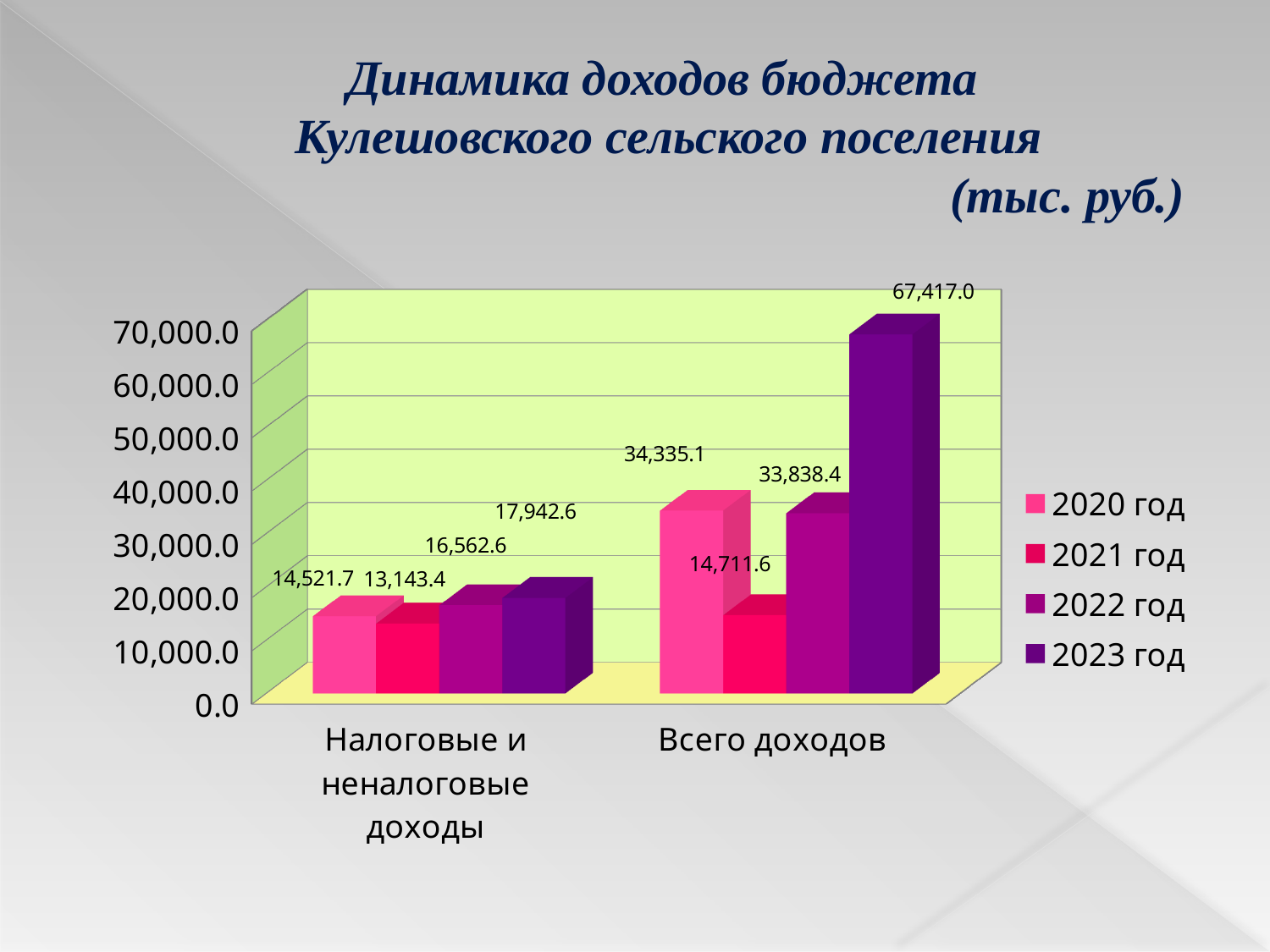
How many series does the legend list? 4 What is the difference between the 2023 год and 2022 год values in the Всего доходов category? 33,578.6 What is the value for 2020 год in the Всего доходов category? 34,335.1 How many categories are shown on the x axis? 2 Which is larger in the Всего доходов category: the value for 2020 год or for 2021 год? 2020 год What type of chart is shown on the slide? bar chart Which year has the lowest value in the Налоговые и неналоговые доходы category? 2021 год What is the value for 2021 год in the Налоговые и неналоговые доходы category? 13,143.4 What is the difference between the 2023 год and 2022 год values in the Налоговые и неналоговые доходы category? 1,380.0 Which year has the highest value in the Всего доходов category? 2023 год What is the value for 2023 год in the Всего доходов category? 67,417.0 Is the value for 2023 год in the Всего доходов category greater or less than 60,000.0? greater